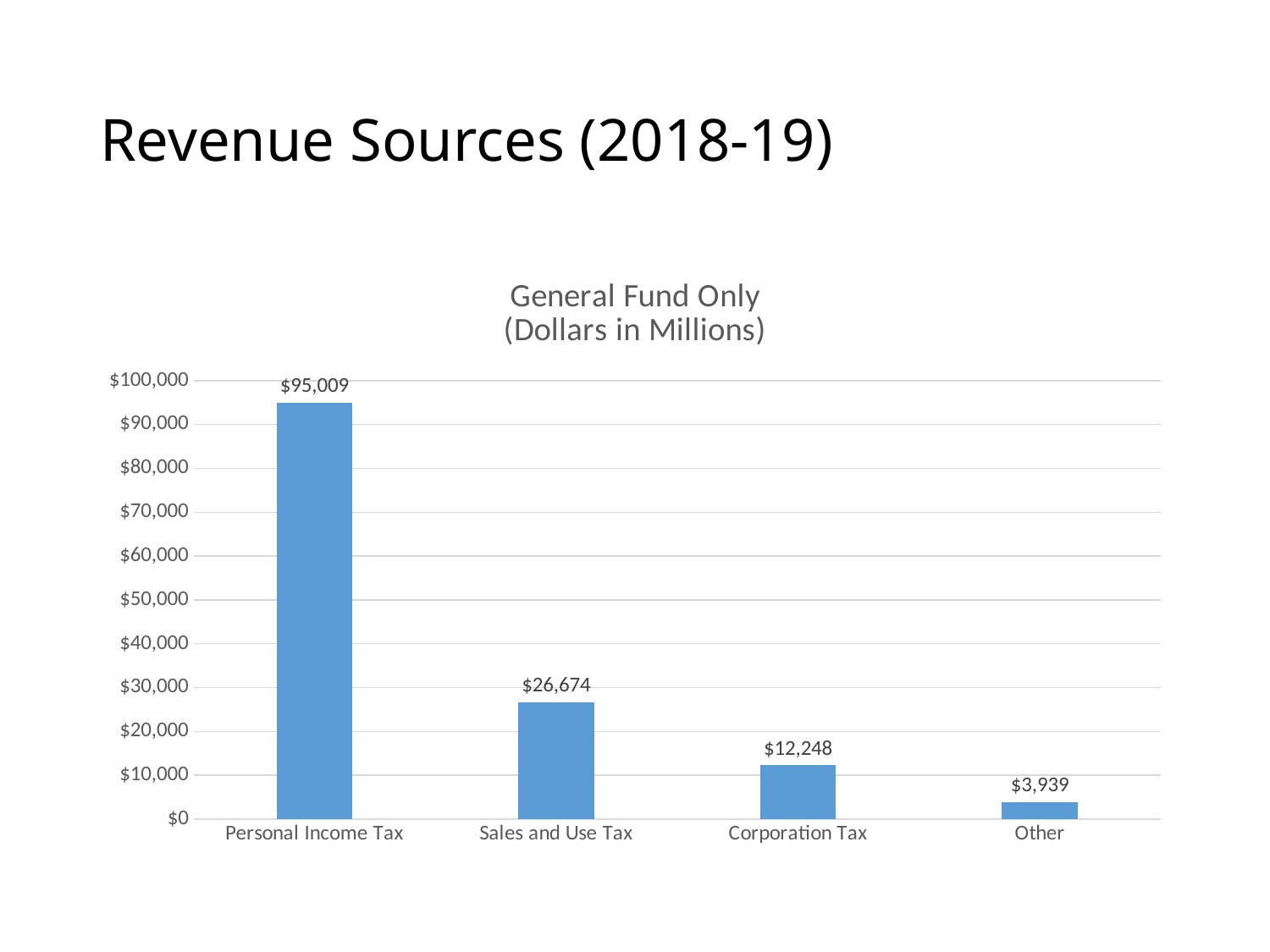
What is the difference between Personal Income Tax and Sales and Use Tax? $68,335 What kind of chart is shown on the slide? Bar chart Which is larger, Sales and Use Tax or Corporation Tax? Sales and Use Tax How many categories are shown on the chart? 4 Which category has the lowest value? Other What is the difference between Corporation Tax and Other? $8,309 What is the value for Other? $3,939 What is the value for Corporation Tax? $12,248 What is the value for Personal Income Tax? $95,009 Which category has the highest value? Personal Income Tax What is the title of the chart? General Fund Only (Dollars in Millions) What is the value for Sales and Use Tax? $26,674